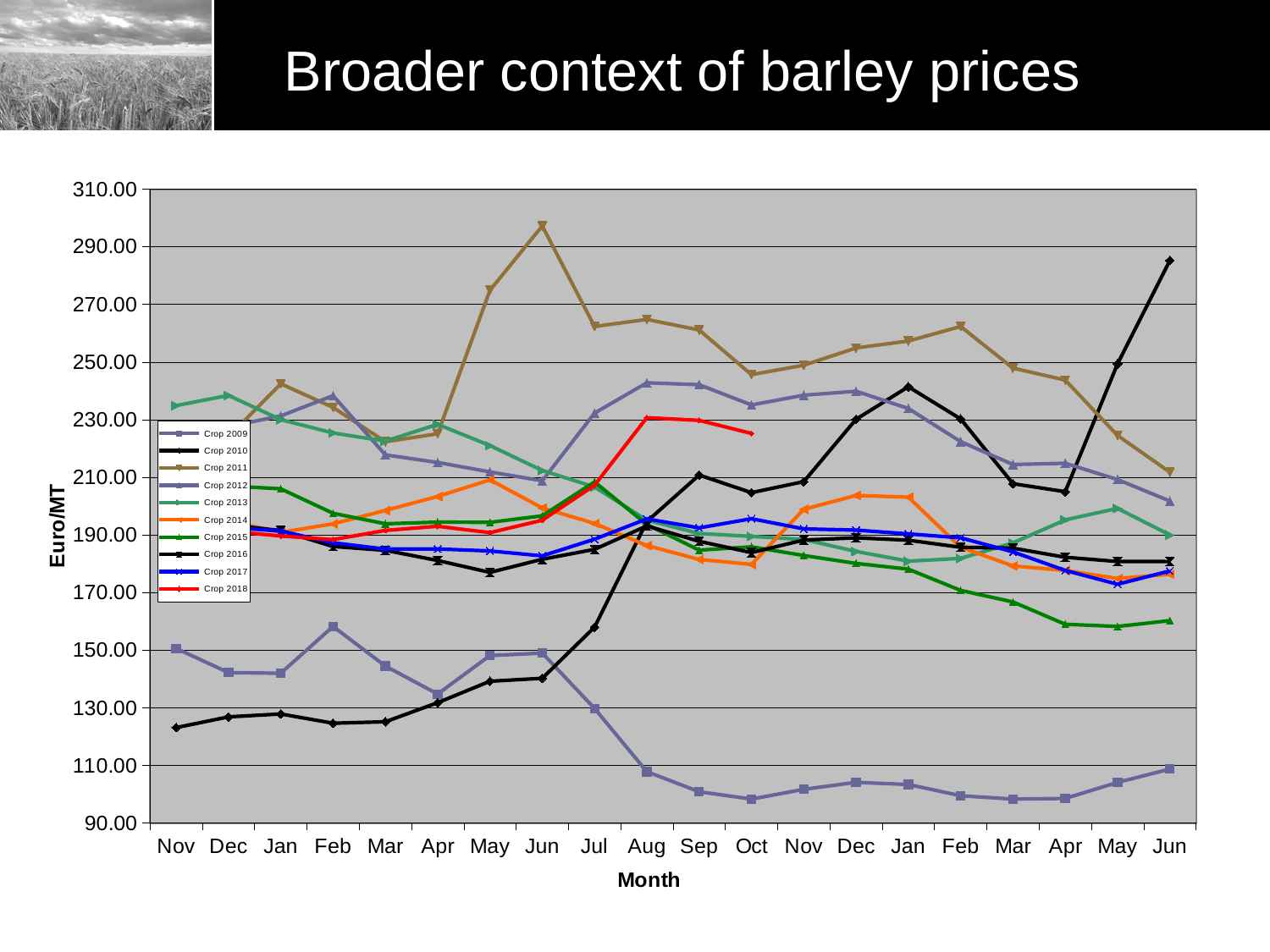
Is the value for Crop 2011 in the first Jun greater or less than 290? greater Does Crop 2010 rise or fall from Apr to the final Jun? rise Is the value for Crop 2010 in the final Jun greater or less than 270? greater What is the title of the vertical axis? Euro/MT What kind of chart is shown on the slide? line chart Which crop series falls to the lowest value anywhere on the chart? Crop 2009 Is the value for Crop 2009 in Oct greater or less than 110? less Which crop series reaches the highest value anywhere on the chart? Crop 2011 How many month points are shown along the x axis? 20 How many series does the legend list? 10 In Jul, which is higher: Crop 2011 or Crop 2009? Crop 2011